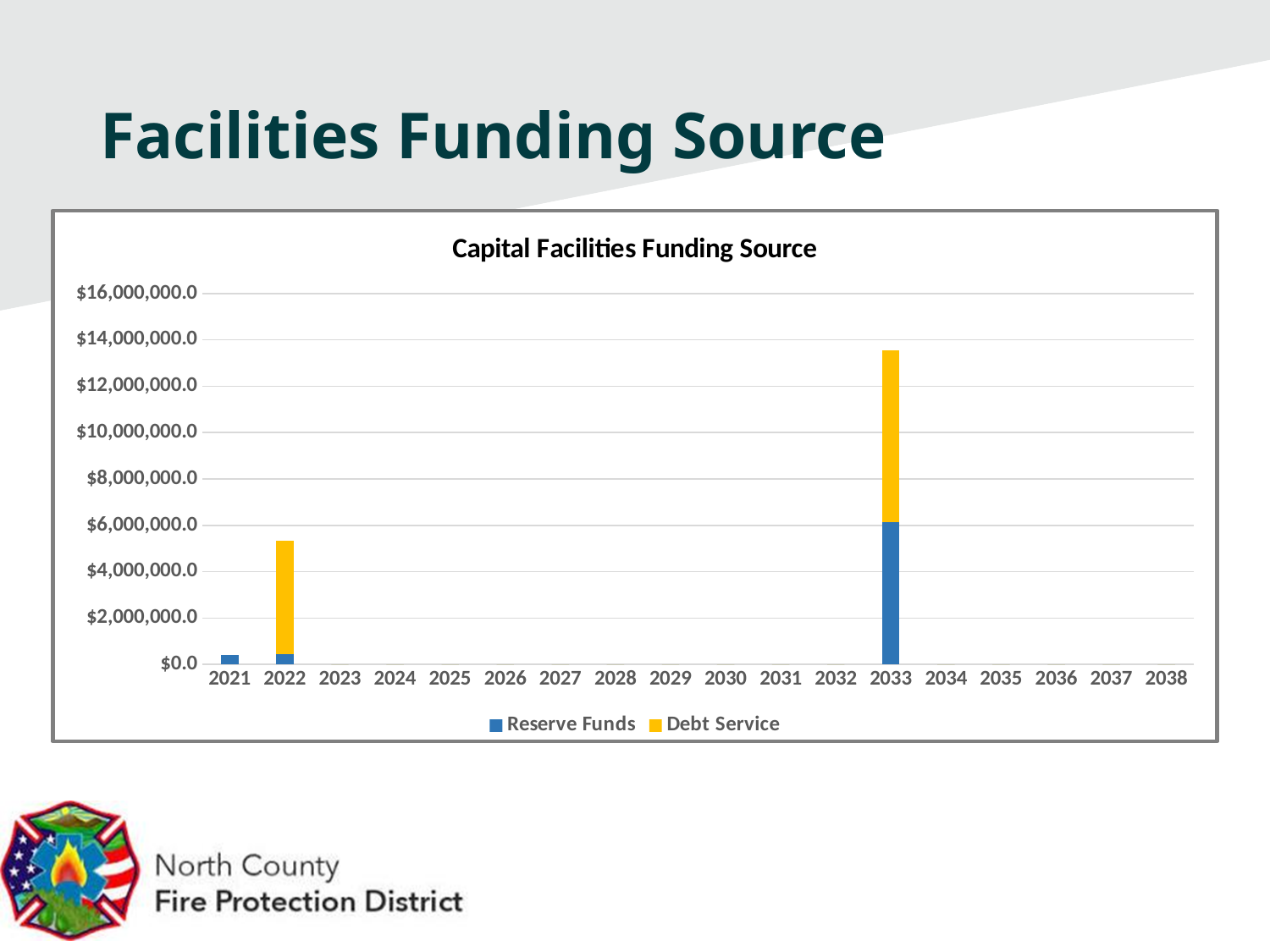
How many years are shown along the x axis? 18 What is the title of the chart? Capital Facilities Funding Source Which series is shown in yellow in the legend? Debt Service Is the Reserve Funds value for 2021 greater or less than $2,000,000.0? less In 2033, which series contributes more, Reserve Funds or Debt Service? Debt Service How many series does the legend list? 2 Which year has the tallest stacked bar? 2033 Which year has a larger total stacked bar, 2022 or 2033? 2033 What type of chart is shown on the slide? Stacked bar chart Is the total stacked bar for 2022 greater or less than $6,000,000.0? less Is the Reserve Funds value for 2033 greater or less than $4,000,000.0? greater